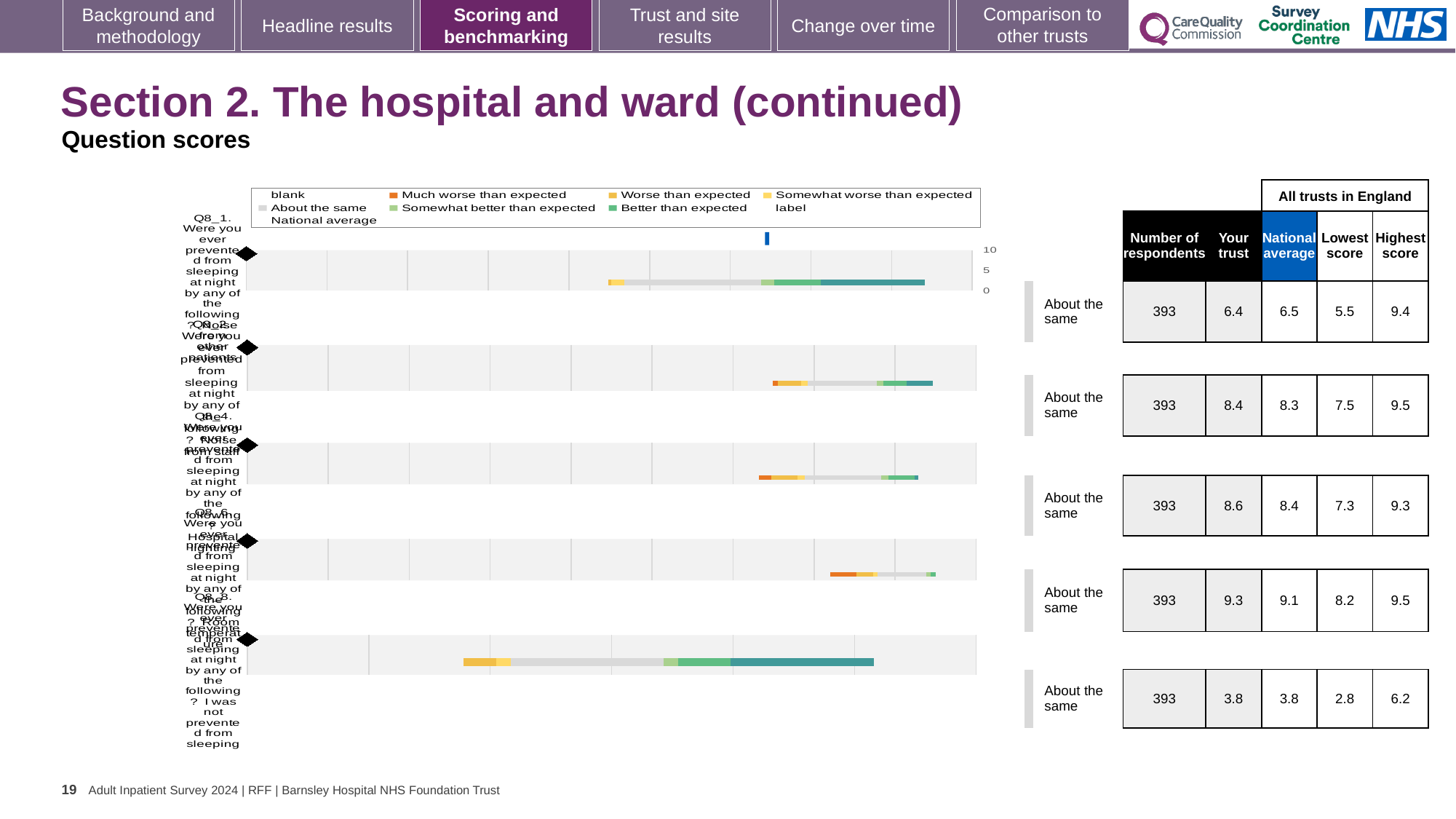
For the first row (Q8_1), what is the difference between the highest score and the lowest score across all trusts in England? 3.9 Which row in the table beside the chart has the lowest 'Your trust' score? the fifth row (Q8_8), 3.8 In the table beside the chart, what is the 'National average' for the first row (Q8_1)? 6.5 In the table beside the chart, what is the 'Your trust' score for the first row (Q8_1)? 6.4 In the table beside the chart, how many respondents are listed for the second row (Q8_2)? 393 In the table beside the chart, what is the 'Highest score' for the fifth row (Q8_8)? 6.2 For the third row (Q8_4), which is larger: the 'Your trust' score or the 'National average'? Your trust What kind of chart is shown on the slide? bar chart What benchmark category is shown next to every bar in the chart? About the same How many horizontal bars (questions) are plotted in the chart? 5 What colour does the legend use for 'Much worse than expected'? orange Which row in the table beside the chart has the highest 'Your trust' score? the fourth row (Q8_6), 9.3